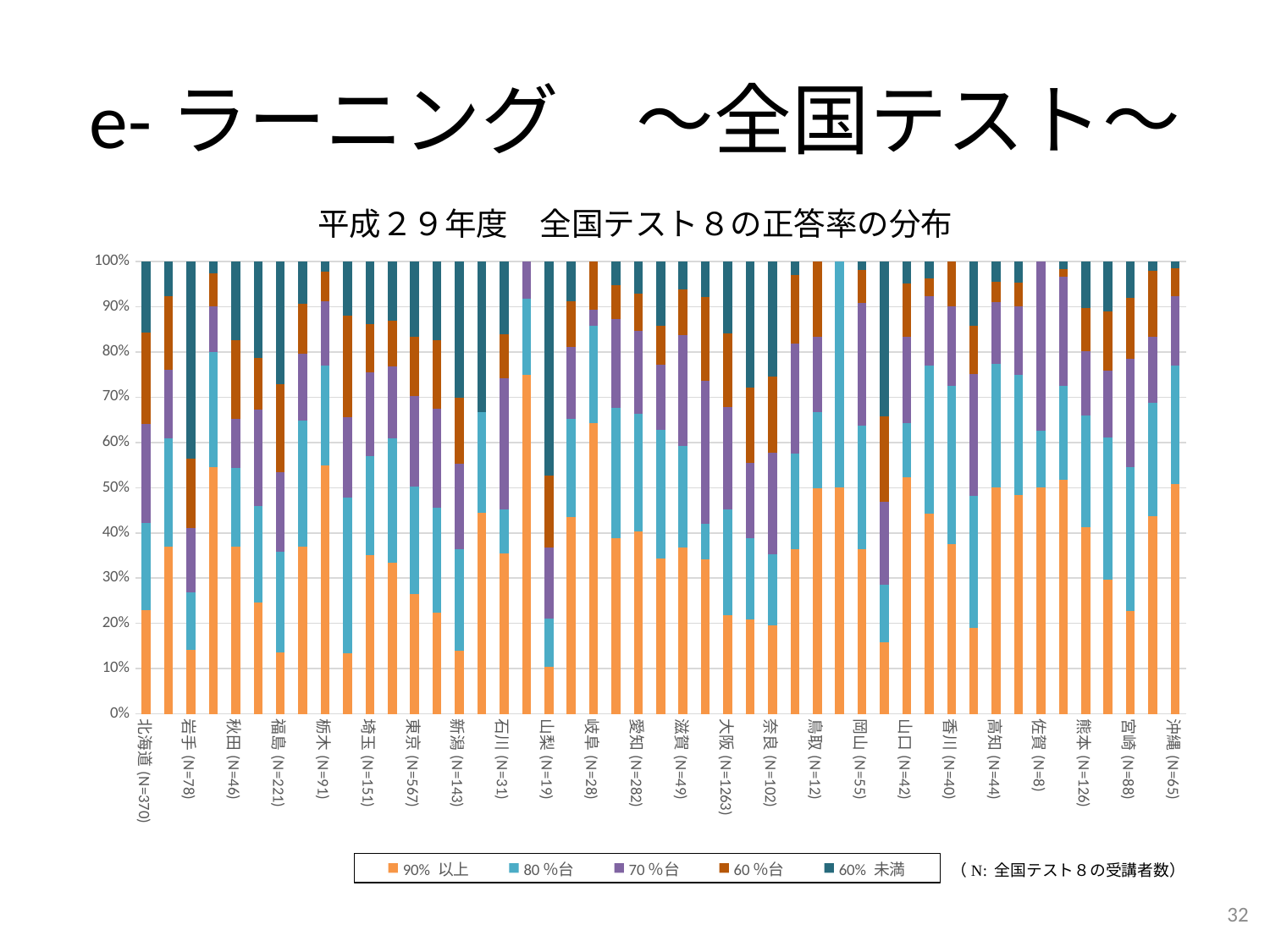
Is the 90% 以上 share for 東京 (N=567) greater or less than 30%? less Is the 90% 以上 share for 岐阜 (N=28) greater or less than 60%? greater Which legend entry is shown in orange (the bottom segment of each bar)? 90% 以上 Is the 90% 以上 share for 秋田 (N=46) greater or less than 50%? less What is the title of the chart? 平成２９年度 全国テスト８の正答率の分布 How many series does the legend list? 5 What kind of chart is shown on the slide? Stacked bar chart Which of 岐阜 (N=28) and 大阪 (N=1263) has the larger 90% 以上 share? 岐阜 (N=28)